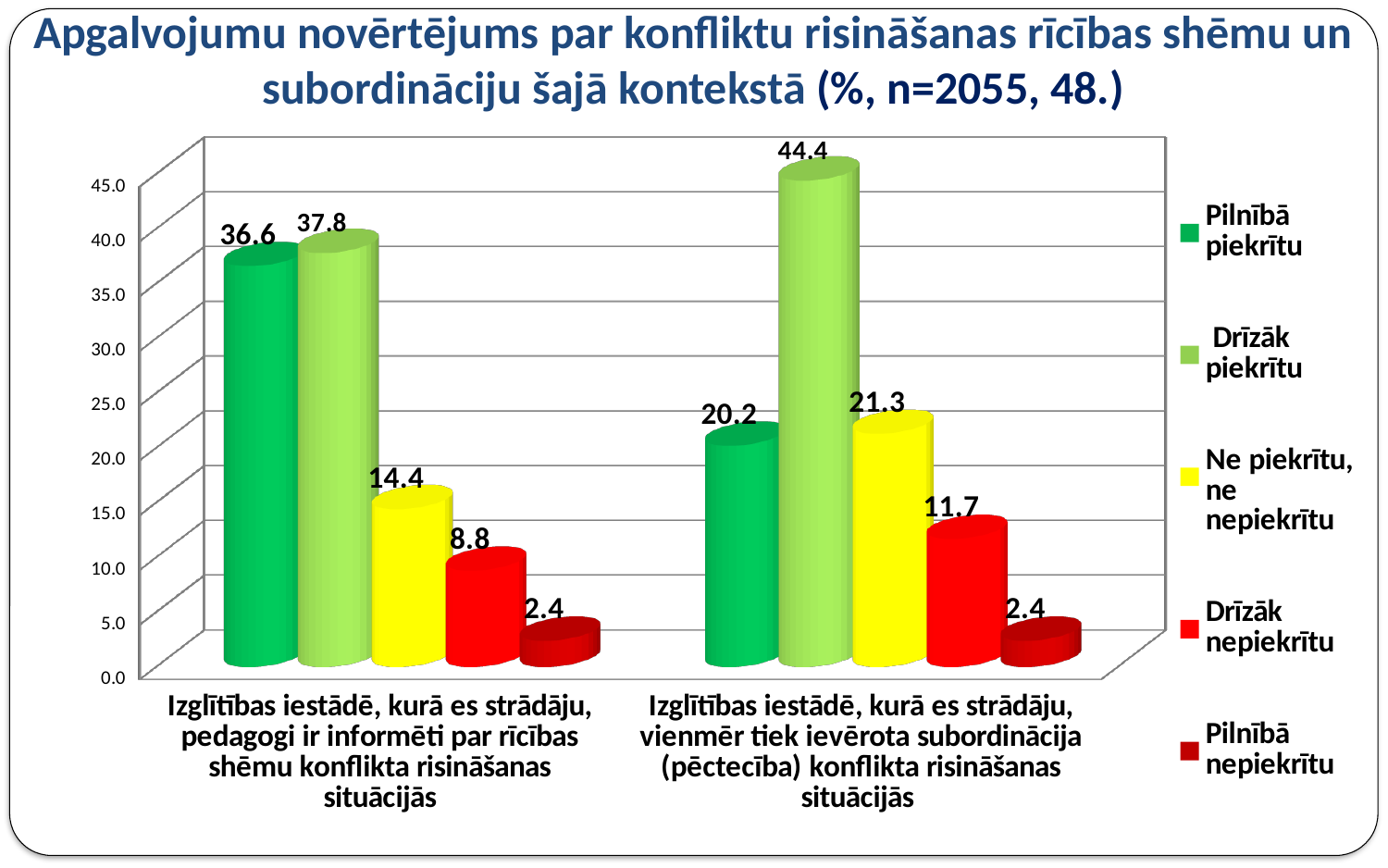
How many categories are shown on the x axis? 2 What kind of chart is shown on the slide? Bar chart Which series has the highest value in the category about subordinācija (pēctecība)? Drīzāk piekrītu What is the value for "Pilnībā piekrītu" in the category "Izglītības iestādē, kurā es strādāju, pedagogi ir informēti par rīcības shēmu konflikta risināšanas situācijās"? 36.6 What is the value for "Ne piekrītu, ne nepiekrītu" in the category about pedagogi ir informēti par rīcības shēmu? 14.4 How many series does the legend list? 5 Which category has the larger value for "Pilnībā piekrītu"? Izglītības iestādē, kurā es strādāju, pedagogi ir informēti par rīcības shēmu konflikta risināšanas situācijās What is the difference between the "Drīzāk piekrītu" values of the two categories? 6.6 What is the value for "Drīzāk piekrītu" in the category "Izglītības iestādē, kurā es strādāju, vienmēr tiek ievērota subordinācija (pēctecība) konflikta risināšanas situācijās"? 44.4 What is the value for "Drīzāk nepiekrītu" in the category about subordinācija (pēctecība)? 11.7 What colour represents "Ne piekrītu, ne nepiekrītu" in the chart? Yellow Which series has the lowest value in the category about pedagogi ir informēti par rīcības shēmu? Pilnībā nepiekrītu